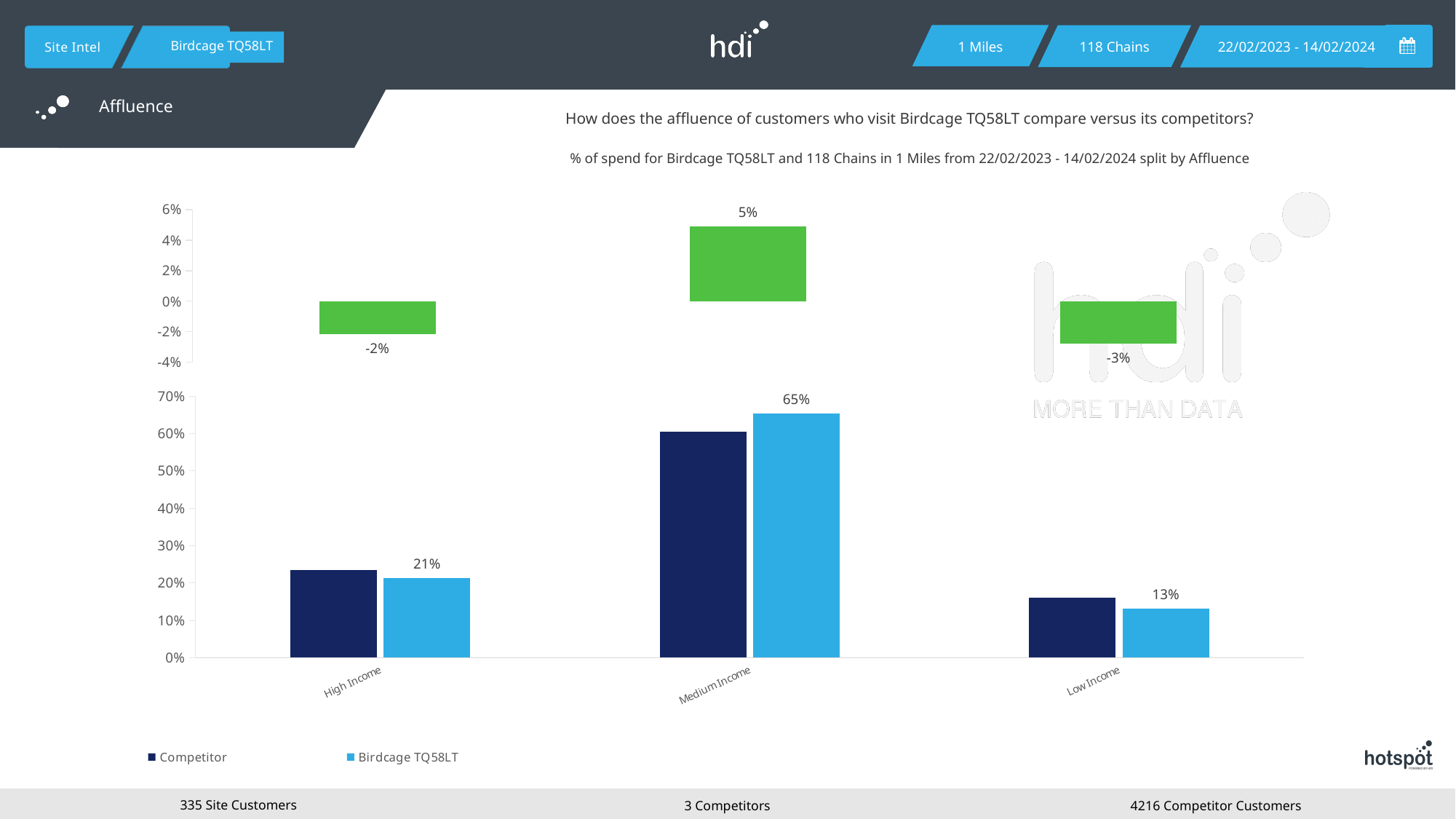
In the bottom bar chart, what is the value for Birdcage TQ58LT in the High Income category? 21% In the bottom bar chart, what is the value for Birdcage TQ58LT in the Medium Income category? 65% In the bottom bar chart, is the Competitor value for Medium Income greater or less than 50%? greater In the bottom bar chart, which category has the highest value for Birdcage TQ58LT? Medium Income In the top chart, which category has the lowest value? Low Income In the bottom bar chart, what is the value for Birdcage TQ58LT in the Low Income category? 13% In the top chart, what is the value shown for Medium Income? 5% How many series does the legend of the bottom bar chart list? 2 In the top chart, what is the value shown for Low Income? -3% In the bottom bar chart, which is larger for Medium Income: the Competitor value or the Birdcage TQ58LT value? Birdcage TQ58LT What type of chart is the bottom chart? Bar chart In the bottom bar chart, what is the difference between the Birdcage TQ58LT values for Medium Income and High Income? 44%